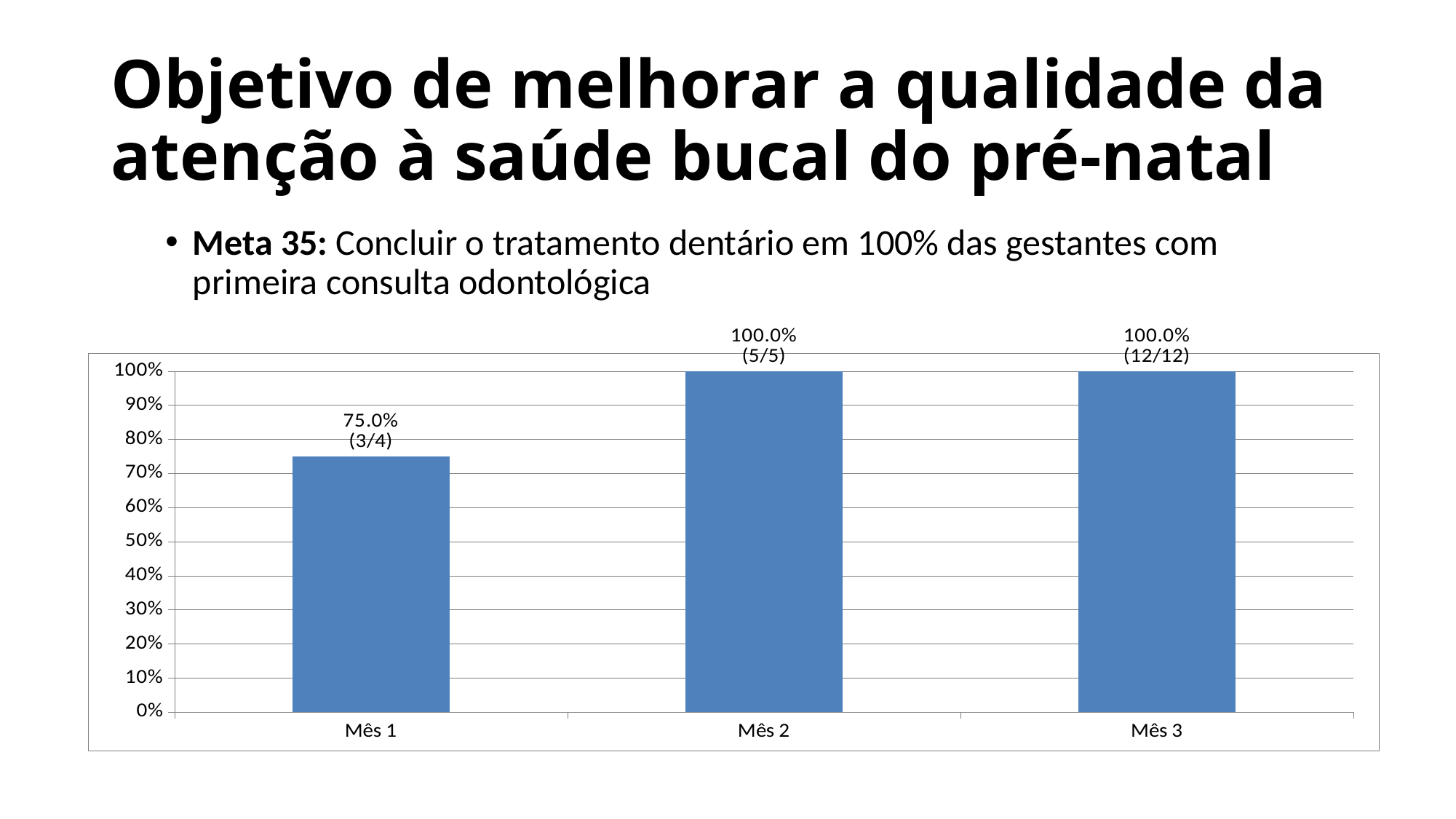
Which month has the lowest value? Mês 1 What colour are the bars in the chart? blue Which is larger, the value for Mês 1 or the value for Mês 3? Mês 3 What is the value for Mês 3? 100.0% What is the value for Mês 2? 100.0% Is the value for Mês 1 greater or less than 80%? less What is the value for Mês 1? 75.0% What fraction is shown in the data label for Mês 3? (12/12) How many categories are shown on the x axis? 3 What is the difference between the values for Mês 2 and Mês 1? 25.0% What kind of chart is shown on the slide? bar chart Do the values rise or fall from Mês 1 to Mês 2? rise